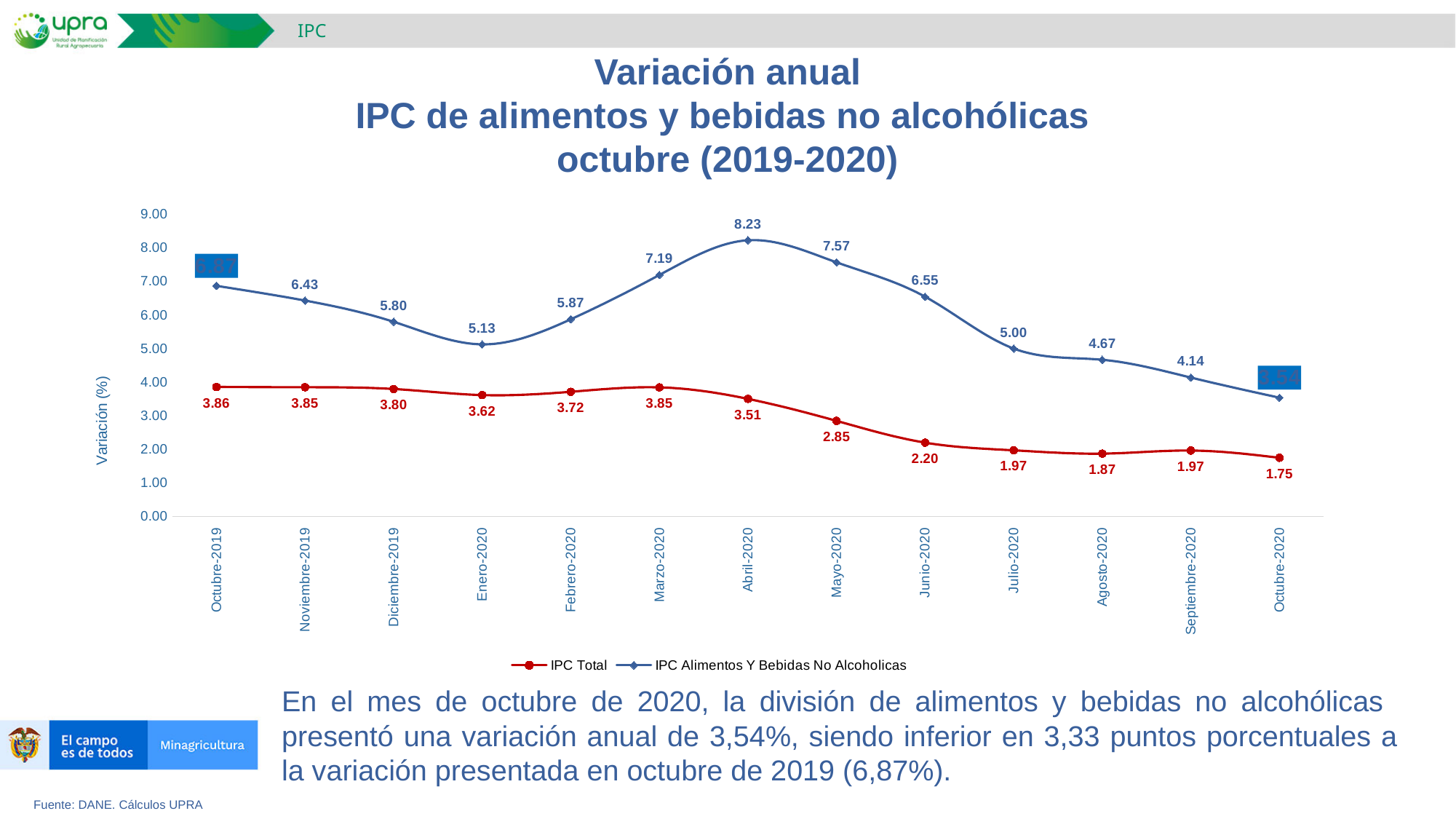
What is the difference between IPC Alimentos Y Bebidas No Alcoholicas and IPC Total in Abril-2020? 4.72 What type of chart is shown on the slide? Line chart How many months are plotted along the x axis? 13 Does IPC Total rise or fall between Marzo-2020 and Octubre-2020? Fall What is the value of IPC Total in Mayo-2020? 2.85 How many series does the legend list? 2 Which is larger in Julio-2020: IPC Total or IPC Alimentos Y Bebidas No Alcoholicas? IPC Alimentos Y Bebidas No Alcoholicas What colour is the line for IPC Total? Red In which month does IPC Total reach its lowest value? Octubre-2020 What is the value of IPC Alimentos Y Bebidas No Alcoholicas in Abril-2020? 8.23 In which month does IPC Alimentos Y Bebidas No Alcoholicas reach its highest value? Abril-2020 What is the value of IPC Alimentos Y Bebidas No Alcoholicas in Enero-2020? 5.13